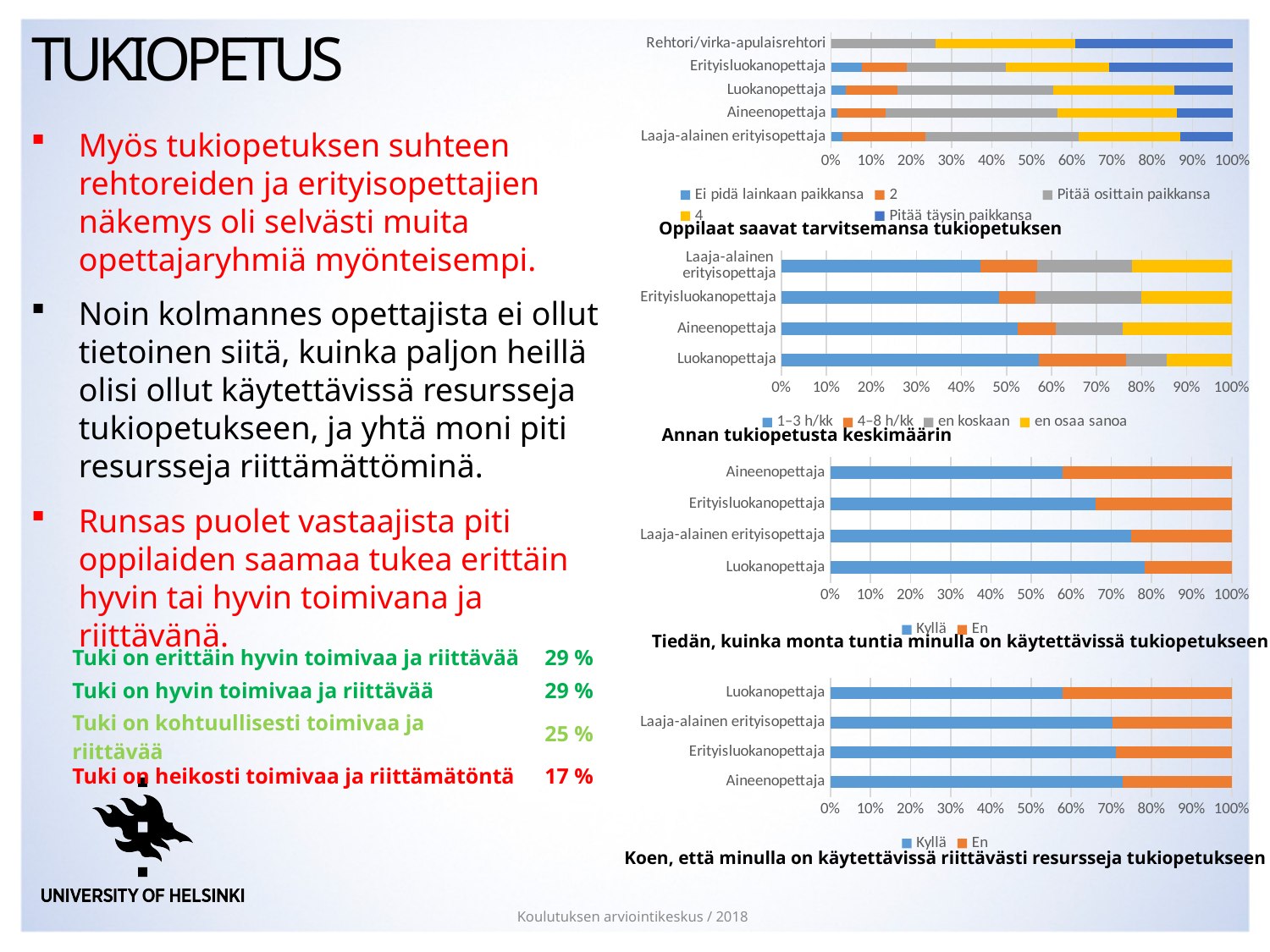
In the chart titled "Koen, että minulla on käytettävissä riittävästi resursseja tukiopetukseen", what are the two legend entries? Kyllä and En In the chart titled "Oppilaat saavat tarvitsemansa tukiopetuksen", is the "Pitää täysin paikkansa" share for Rehtori/virka-apulaisrehtori greater or less than 30%? greater In the chart titled "Tiedän, kuinka monta tuntia minulla on käytettävissä tukiopetukseen", which has the larger "Kyllä" share: Aineenopettaja or Luokanopettaja? Luokanopettaja In the chart titled "Oppilaat saavat tarvitsemansa tukiopetuksen", how many respondent groups (categories) are shown? 5 In the chart titled "Tiedän, kuinka monta tuntia minulla on käytettävissä tukiopetukseen", is the "Kyllä" share for Luokanopettaja greater or less than 70%? greater In the chart titled "Koen, että minulla on käytettävissä riittävästi resursseja tukiopetukseen", which group has the lowest "Kyllä" share? Luokanopettaja In the chart titled "Tiedän, kuinka monta tuntia minulla on käytettävissä tukiopetukseen", which group has the lowest "Kyllä" share? Aineenopettaja In the chart titled "Oppilaat saavat tarvitsemansa tukiopetuksen", how many series does the legend list? 5 In the chart titled "Annan tukiopetusta keskimäärin", is the "1–3 h/kk" share for Luokanopettaja greater or less than 50%? greater What kind of chart is "Annan tukiopetusta keskimäärin"? Stacked bar chart In the chart titled "Annan tukiopetusta keskimäärin", how many series does the legend list? 4